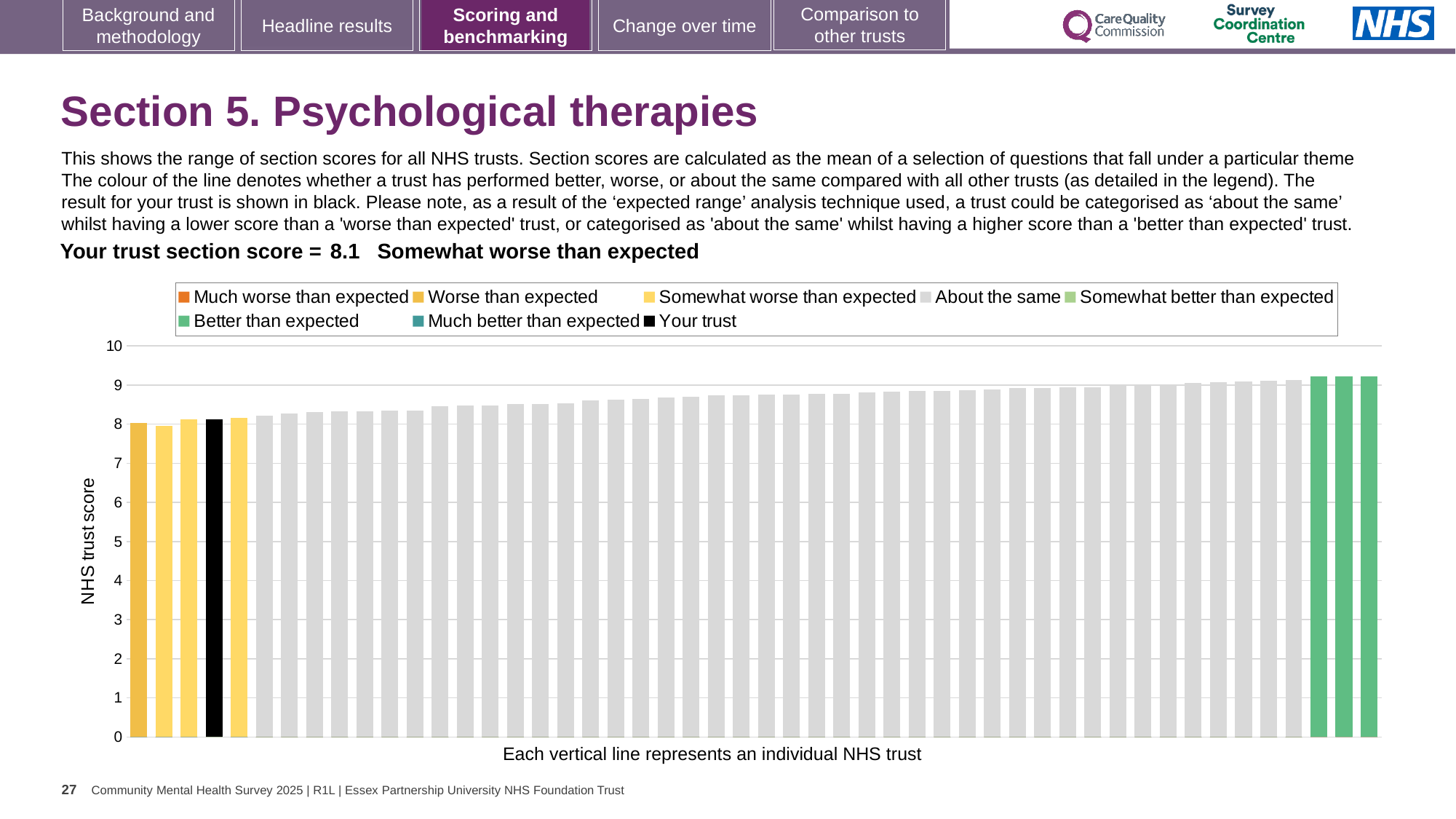
How many bars are coloured green ('Better than expected')? 3 Is the value of the black 'Your trust' bar greater or less than 7? greater What is the label on the vertical axis of the chart? NHS trust score What is the section score for your trust shown on the slide? 8.1 How many bars are coloured in the 'Somewhat worse than expected' yellow shade? 3 Is the value of the black 'Your trust' bar greater or less than 9? less Are the tallest bars on the right of the chart greater or less than 10? less How many bars are coloured in the 'Worse than expected' shade? 1 Do the bar values rise or fall moving from left to right along the x axis? Rise What kind of chart is shown on the slide? Bar chart How many entries does the chart legend list? 8 Which category is your trust placed in according to the text above the chart? Somewhat worse than expected